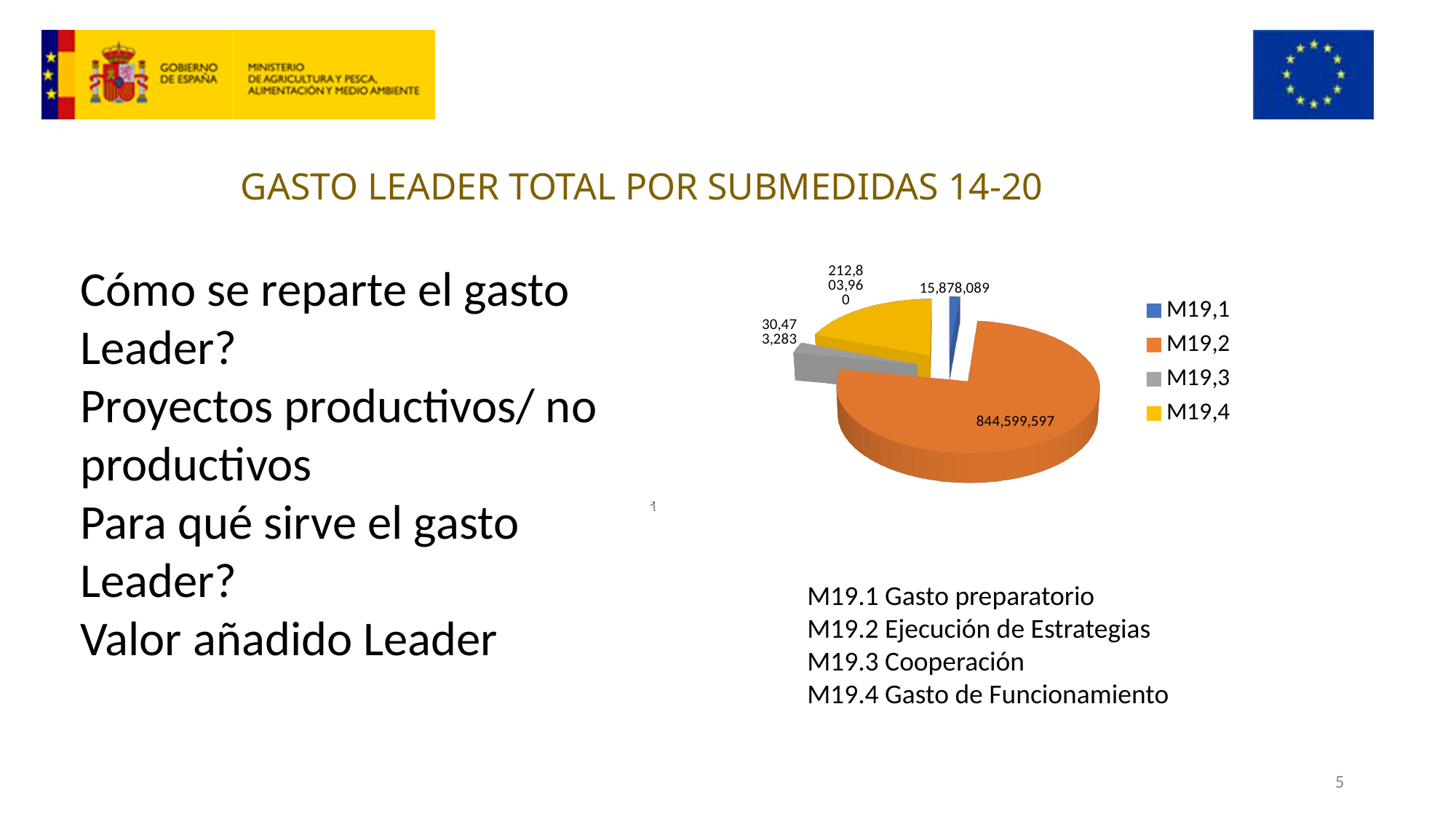
Which submeasure has the largest slice in the pie chart? M19,2 How many slices does the pie chart have? 4 What is the value for M19,3 in the pie chart? 30,473,283 What colour is the M19,4 slice in the pie chart? Yellow Which submeasure has the smallest slice in the pie chart? M19,1 Which is larger, the value for M19,3 or the value for M19,4? M19,4 What is the value for M19,1 in the pie chart? 15,878,089 How many entries does the legend of the pie chart list? 4 What kind of chart is shown on the slide? Pie chart What is the value for M19,2 in the pie chart? 844,599,597 What is the value for M19,4 in the pie chart? 212,803,960 What is the difference between the values for M19,2 and M19,1? 828,721,508